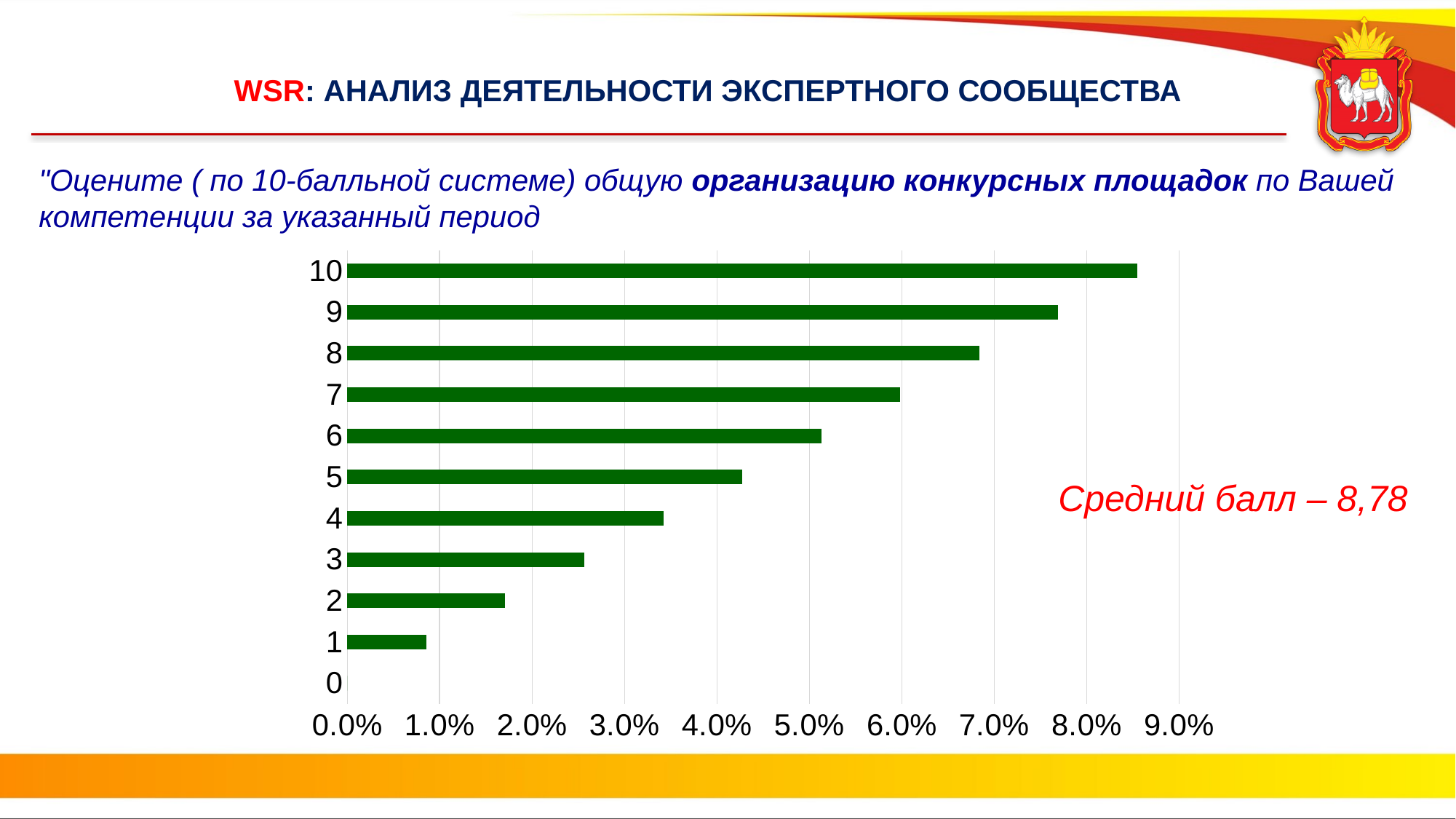
Do the bar values increase or decrease as the score goes from 1 to 10? increase Among the categories with a visible bar, which has the shortest bar? 1 What average score (Средний балл) is stated next to the chart? 8,78 Is the value for category 4 greater or less than 4.0%? less Is the value for category 9 greater or less than 7.0%? greater How many category labels are shown on the vertical axis? 11 Is the value for category 2 greater or less than 2.0%? less Which category has the longest bar? 10 Which has the larger value, category 9 or category 8? 9 What kind of chart is shown on the slide? bar chart